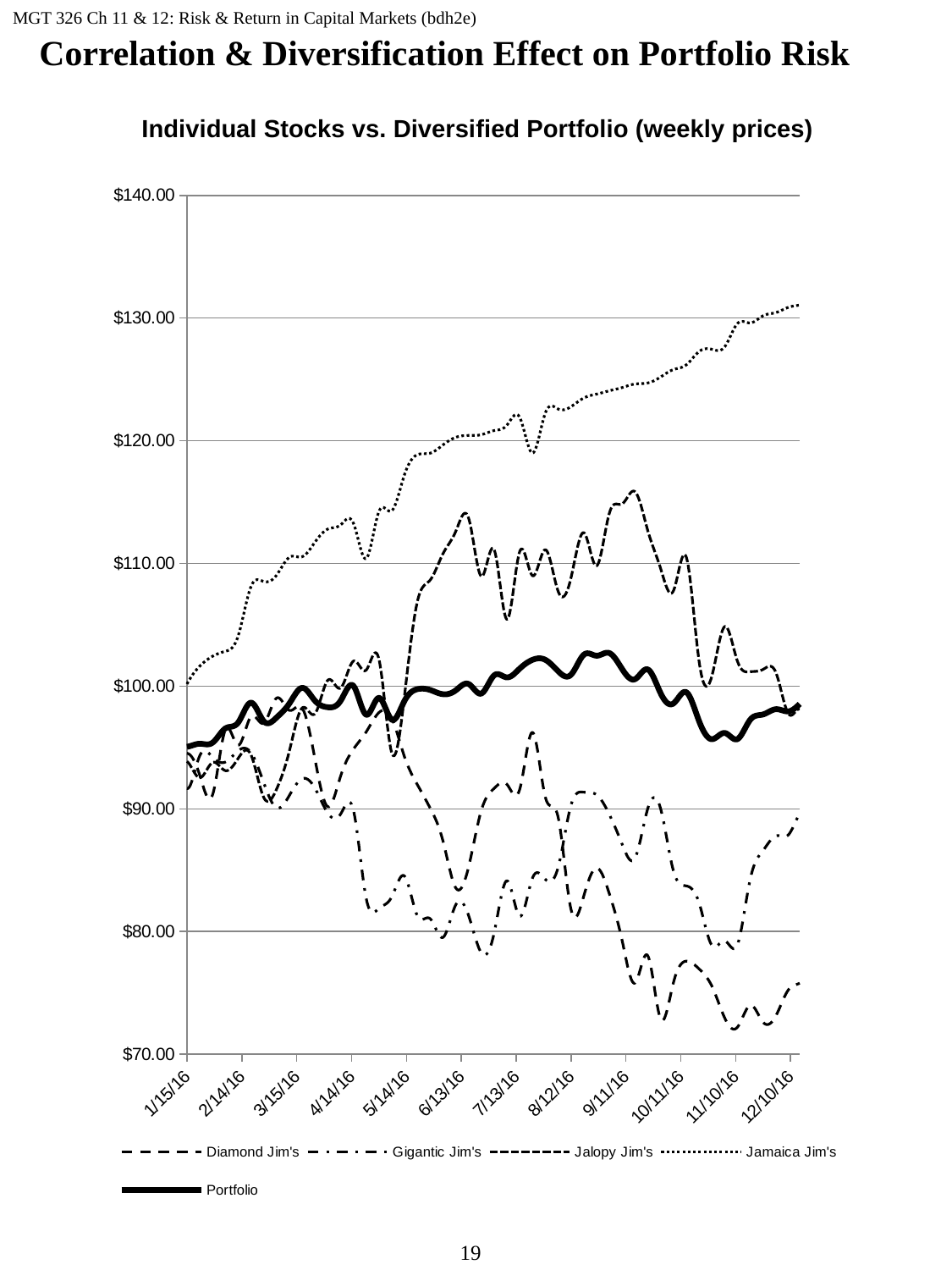
At 12/10/16, which is higher: Jamaica Jim's or Gigantic Jim's? Jamaica Jim's Is the value for Portfolio at 12/10/16 greater or less than $100.00? less Which series has the lowest value at 12/10/16? Diamond Jim's Which series is drawn with the thick solid line? Portfolio How many series does the legend list? 5 Is the value for Jamaica Jim's at 12/10/16 greater or less than $120.00? greater Is the value for Diamond Jim's at 12/10/16 greater or less than $80.00? less Which series has the highest value at 12/10/16? Jamaica Jim's Does the Diamond Jim's line rise or fall overall from 1/15/16 to 12/10/16? fall What kind of chart is shown on the slide? line chart What is the title of the chart? Individual Stocks vs. Diversified Portfolio (weekly prices) Does the Jamaica Jim's line rise or fall from 1/15/16 to 12/10/16? rise